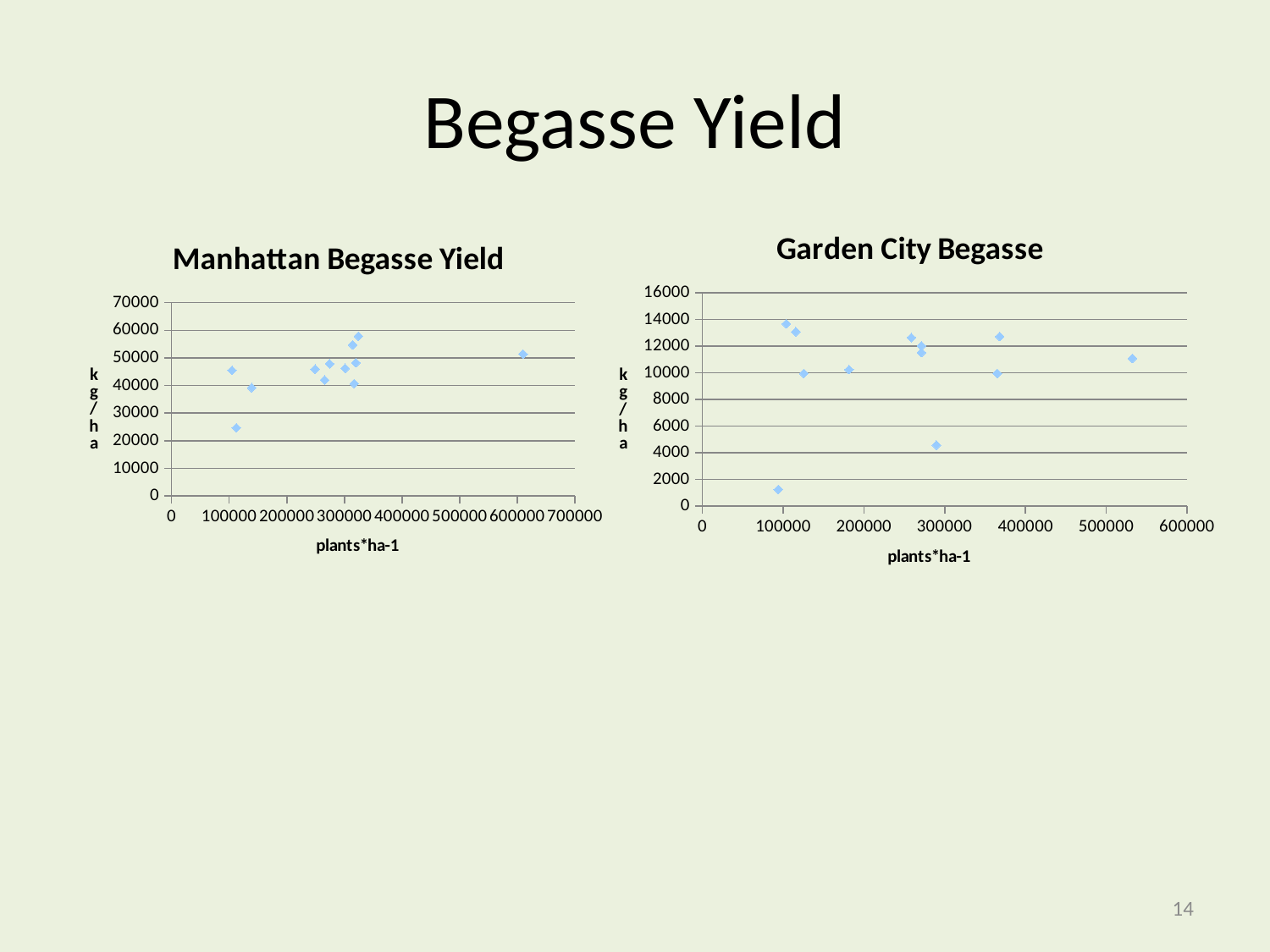
How many charts are shown on the slide? 2 In the Manhattan Begasse Yield chart, what is the label on the x axis? plants*ha-1 In the Manhattan Begasse Yield chart, is the highest plotted point greater or less than 50000 kg/ha? greater In the Garden City Begasse chart, is the point plotted at the highest plant density (around 530000 plants*ha-1) greater or less than 10000 kg/ha? greater In the Manhattan Begasse Yield chart, is the lowest plotted point greater or less than 30000 kg/ha? less What type of chart is the Manhattan Begasse Yield chart? scatter chart In the Garden City Begasse chart, what is the highest value shown on the y axis? 16000 What type of chart is the Garden City Begasse chart? scatter chart Which chart has the higher maximum value on its y axis, Manhattan Begasse Yield or Garden City Begasse? Manhattan Begasse Yield